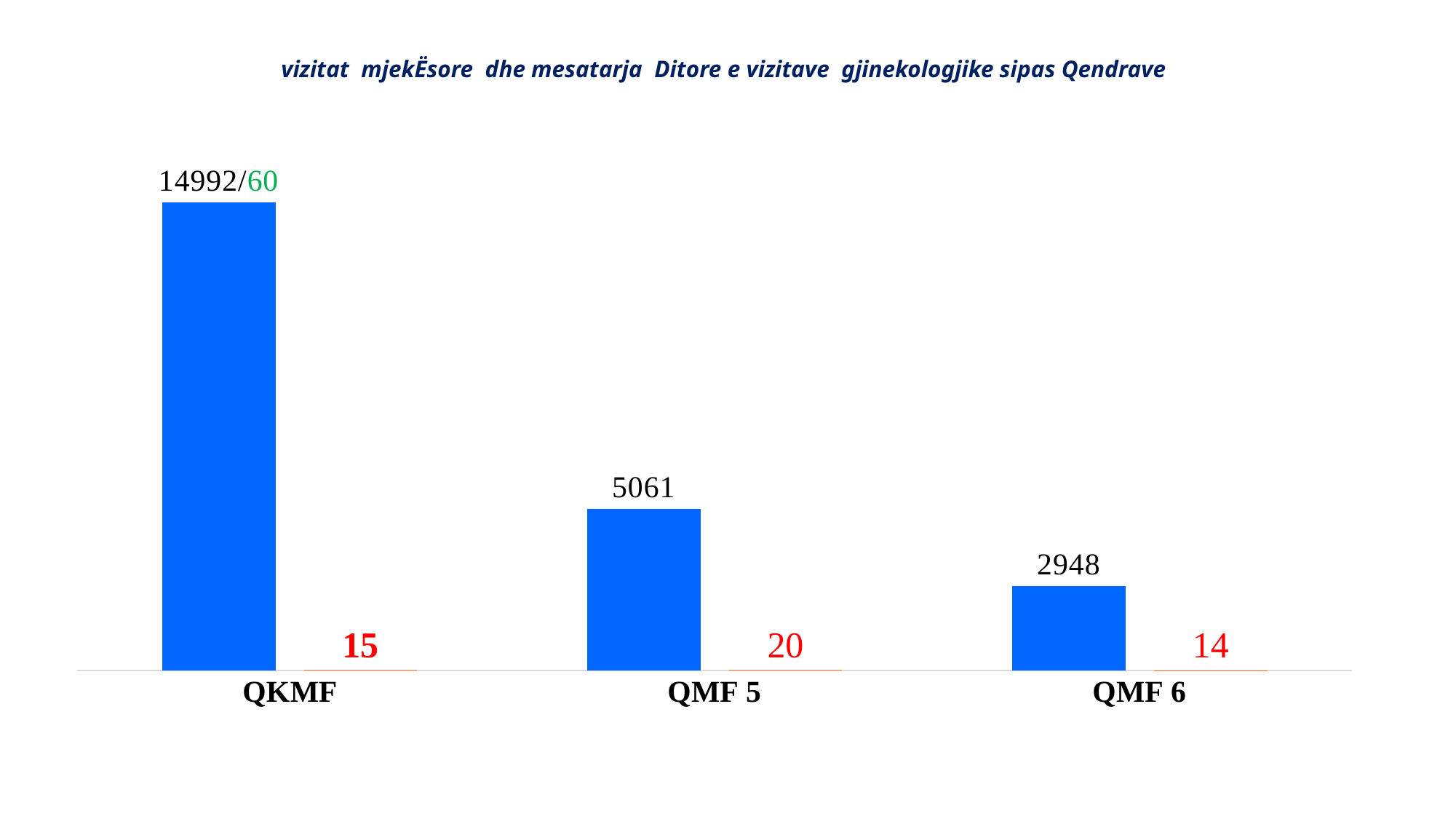
What data label is printed above the blue bar for QKMF? 14992/60 What is the red daily-average value shown for QMF 5? 20 Which is larger, the red daily-average value for QKMF or for QMF 5? QMF 5 What is the red daily-average value shown for QMF 6? 14 What is the value of the blue bar for QMF 6? 2948 What is the difference between the blue bar values for QMF 5 and QMF 6? 2113 What kind of chart is shown on the slide? bar chart Which centre has the highest blue bar (most medical visits)? QKMF Which centre has the lowest red daily-average value? QMF 6 What is the value of the blue bar for QMF 5? 5061 How many centres (categories) are shown on the x axis? 3 Do the blue bar values rise or fall from QKMF to QMF 6 along the x axis? fall